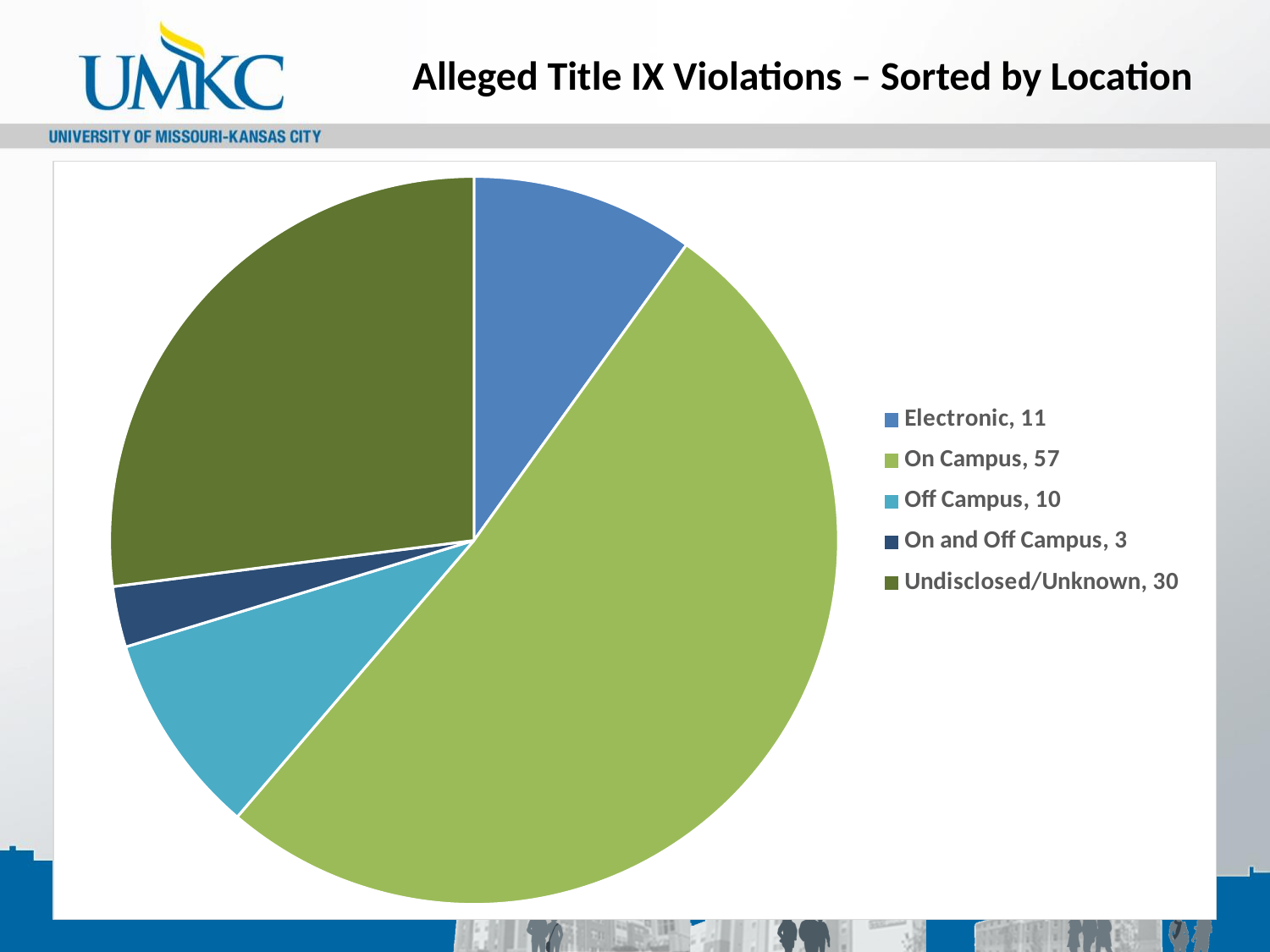
What is the title of the chart on the slide? Alleged Title IX Violations – Sorted by Location What is the value for Electronic? 11 How many alleged Title IX violations are listed for On Campus? 57 What type of chart is shown on the slide? Pie chart What is the value for On and Off Campus? 3 What is the value for Undisclosed/Unknown? 30 Which location category has the largest number of alleged violations? On Campus Which is larger, the value for Off Campus or the value for Undisclosed/Unknown? Undisclosed/Unknown Which location category has the smallest number of alleged violations? On and Off Campus What is the difference between the On Campus and Undisclosed/Unknown values? 27 How many categories does the pie chart have? 5 What is the total number of alleged violations across all categories in the pie chart? 111